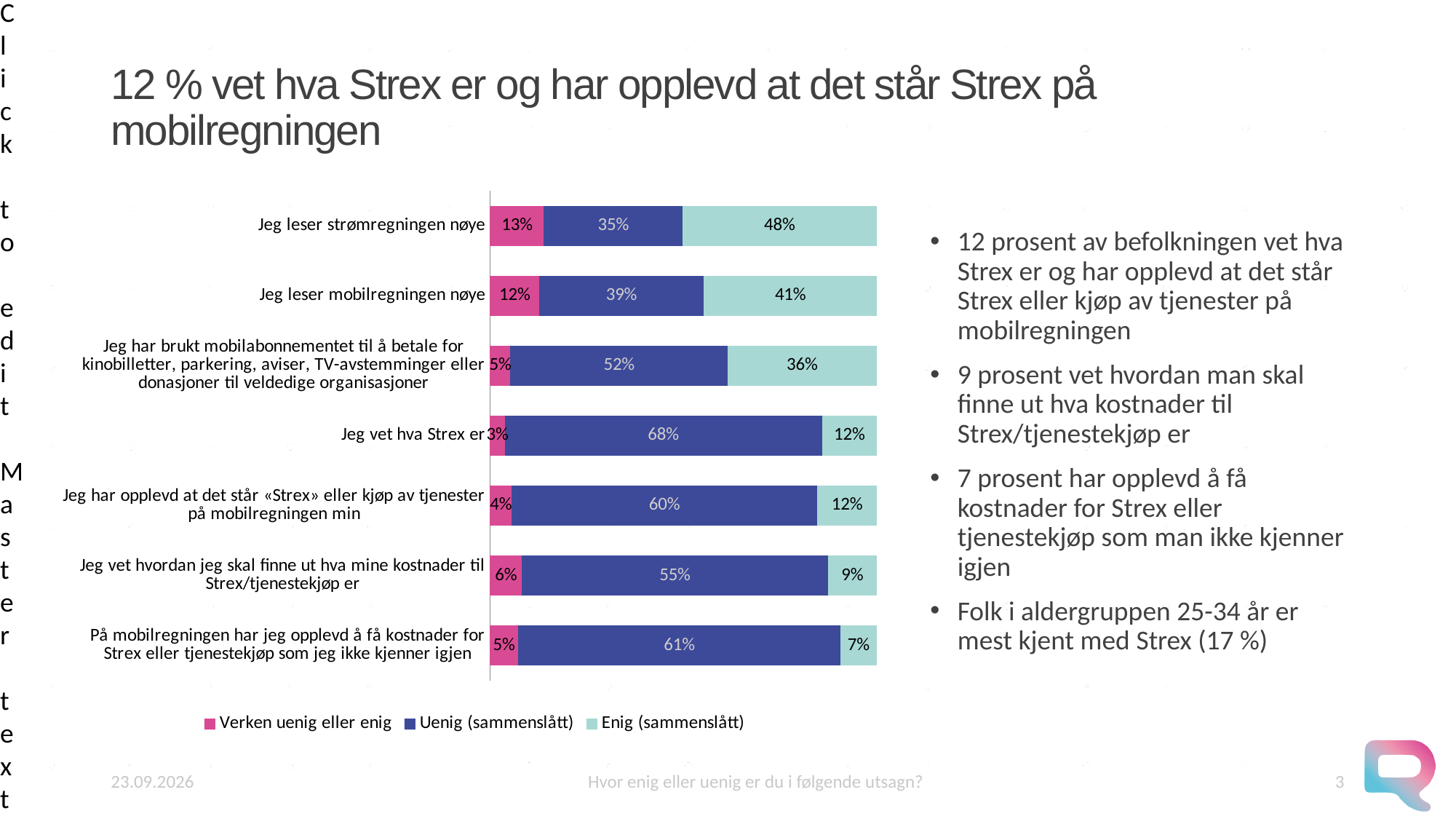
Which statement has the highest "Uenig (sammenslått)" percentage? Jeg vet hva Strex er How many statements (categories) are shown in the chart? 7 What is the total of the three segments for "Jeg leser strømregningen nøye"? 96% What percentage is shown for "Enig (sammenslått)" for "Jeg leser strømregningen nøye"? 48% How many series does the legend list? 3 What is the difference in "Enig (sammenslått)" between "Jeg leser strømregningen nøye" and "Jeg leser mobilregningen nøye"? 7 percentage points What percentage is shown for "Uenig (sammenslått)" for "Jeg vet hva Strex er"? 68% Which statement has the highest "Enig (sammenslått)" percentage? Jeg leser strømregningen nøye What kind of chart is shown on the slide? Stacked bar chart Which has a larger "Uenig (sammenslått)" share: "Jeg leser mobilregningen nøye" or "Jeg leser strømregningen nøye"? Jeg leser mobilregningen nøye What percentage is shown for "Verken uenig eller enig" for "Jeg leser mobilregningen nøye"? 12% Which statement has the lowest "Enig (sammenslått)" percentage? På mobilregningen har jeg opplevd å få kostnader for Strex eller tjenestekjøp som jeg ikke kjenner igjen